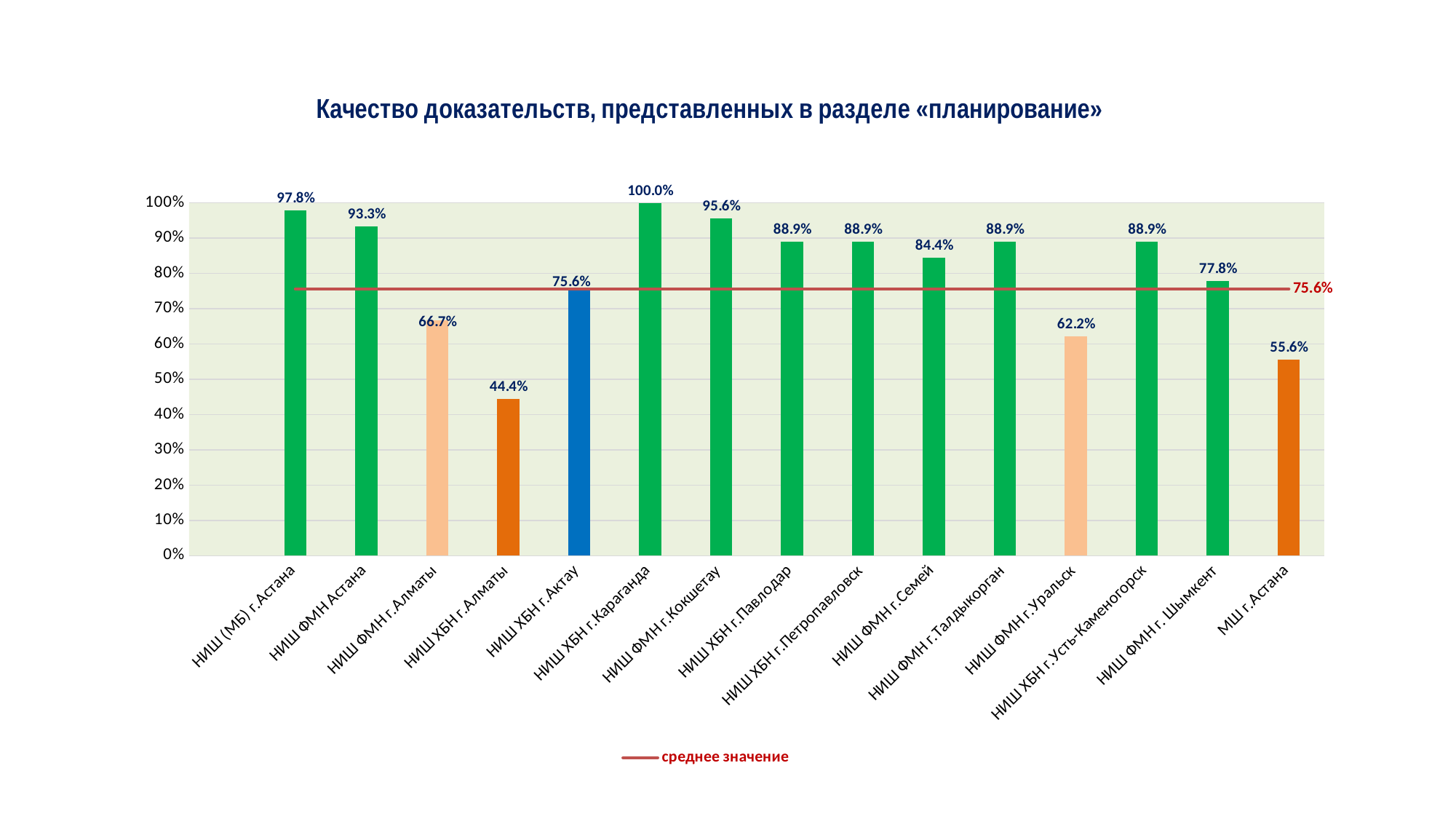
What is the title of the chart? Качество доказательств, представленных в разделе «планирование» What is the difference between the values for НИШ (МБ) г.Астана and НИШ ФМН Астана? 4.5% What is the value for МШ г.Астана? 55.6% Is the value for НИШ ФМН г.Алматы greater or less than 70%? less What is the value for НИШ ФМН г.Уральск? 62.2% What kind of chart is shown on the slide? bar chart What is the value for НИШ ХБН г.Караганда? 100.0% How many categories are shown on the x axis? 15 Which category has the lowest value? НИШ ХБН г.Алматы What value is shown for the average line (среднее значение)? 75.6% Which is larger, the value for НИШ ФМН г.Семей or the value for НИШ ФМН г. Шымкент? НИШ ФМН г.Семей Which category has the highest value? НИШ ХБН г.Караганда